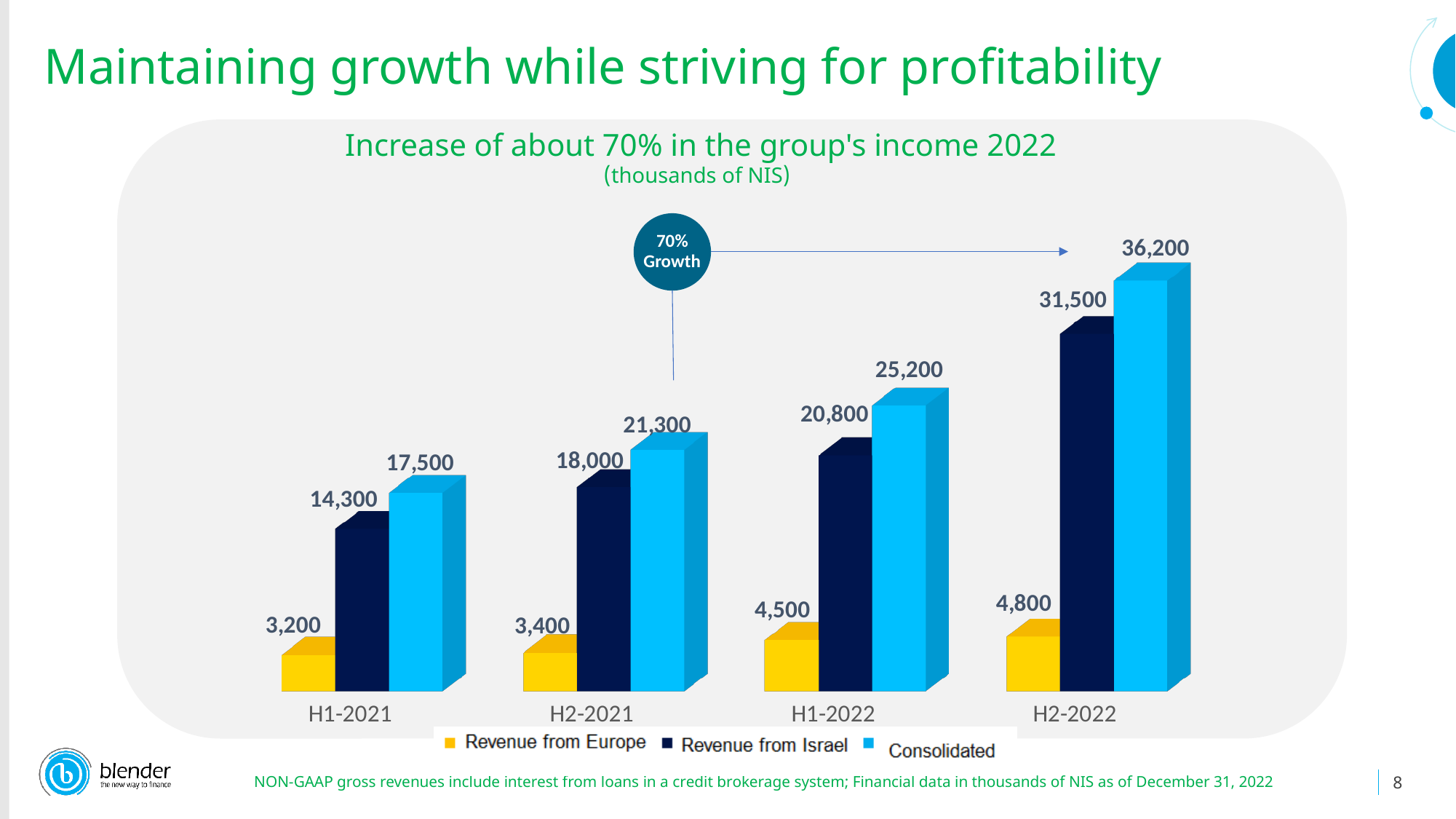
What is the difference between the Consolidated values for H2-2022 and H1-2022? 11,000 Which period has the highest Consolidated value? H2-2022 How many periods are shown on the x axis? 4 Which period has the lowest Revenue from Europe value? H1-2021 Do the Consolidated values rise or fall from H1-2021 to H2-2022? Rise What is the Revenue from Europe value for H1-2022? 4,500 What is the Revenue from Israel value for H1-2021? 14,300 How many series does the legend list? 3 What kind of chart is shown on the slide? Bar chart Which is larger: Revenue from Israel in H2-2021 or Revenue from Israel in H1-2022? H1-2022 What is the difference between Revenue from Israel and Revenue from Europe in H2-2021? 14,600 What is the Consolidated value for H2-2022? 36,200